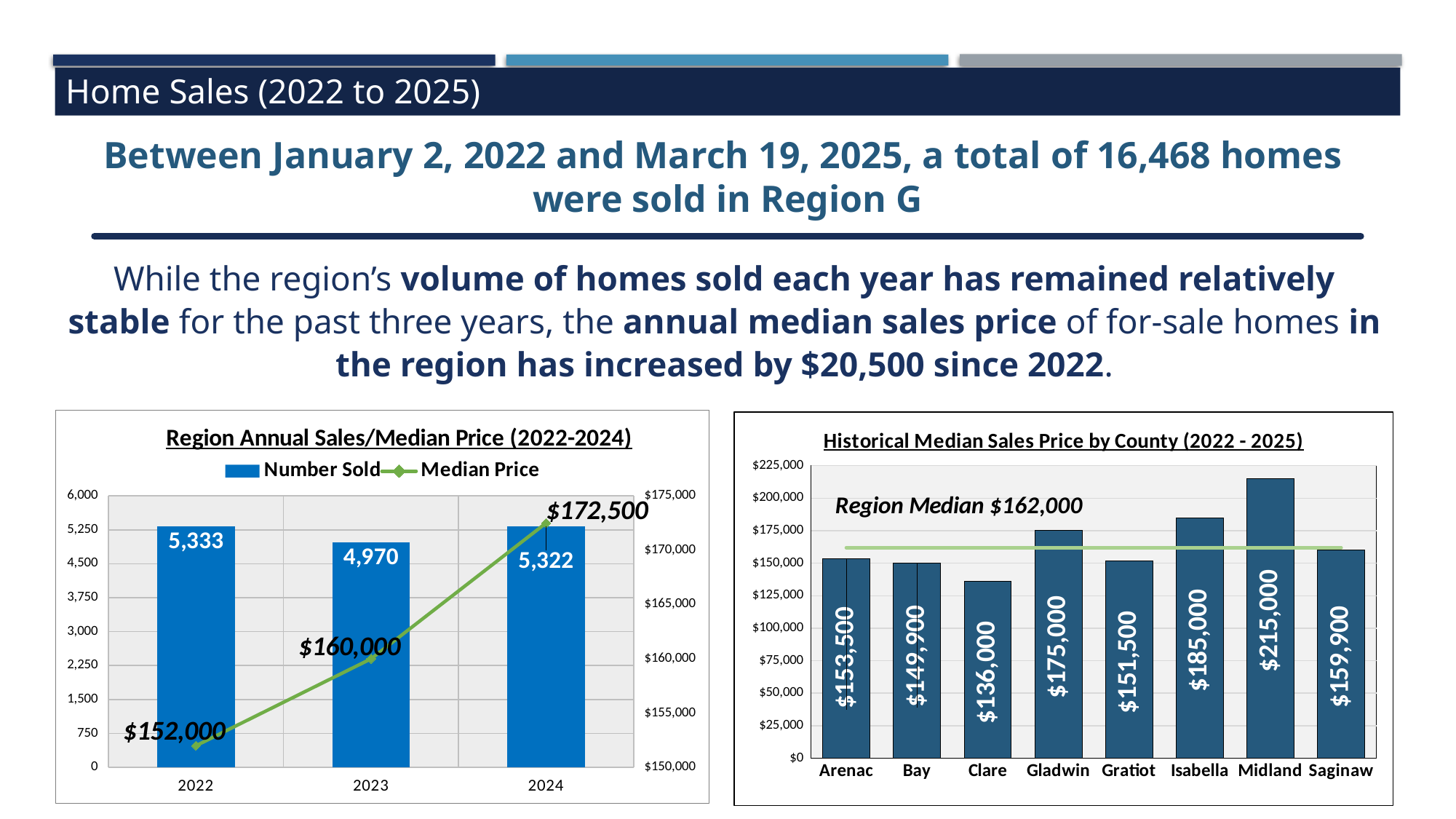
In the 'Historical Median Sales Price by County (2022 - 2025)' chart, what is the difference between the median sales prices of Midland and Saginaw? $55,100 How many series does the legend of the 'Region Annual Sales/Median Price (2022-2024)' chart list? 2 In the 'Historical Median Sales Price by County (2022 - 2025)' chart, what is the median sales price for Gladwin? $175,000 What type of chart is the 'Historical Median Sales Price by County (2022 - 2025)' chart? bar chart In the 'Region Annual Sales/Median Price (2022-2024)' chart, how many homes were sold in 2023? 4,970 In the 'Region Annual Sales/Median Price (2022-2024)' chart, what was the median price in 2024? $172,500 In the 'Region Annual Sales/Median Price (2022-2024)' chart, which year had the highest number of homes sold? 2022 In the 'Historical Median Sales Price by County (2022 - 2025)' chart, which county has the highest median sales price? Midland In the 'Historical Median Sales Price by County (2022 - 2025)' chart, which county has the lowest median sales price? Clare In the 'Region Annual Sales/Median Price (2022-2024)' chart, what is the difference in median price between 2022 and 2024? $20,500 In the 'Region Annual Sales/Median Price (2022-2024)' chart, does the median price rise or fall from 2022 to 2024? rise In the 'Historical Median Sales Price by County (2022 - 2025)' chart, how many counties are shown? 8